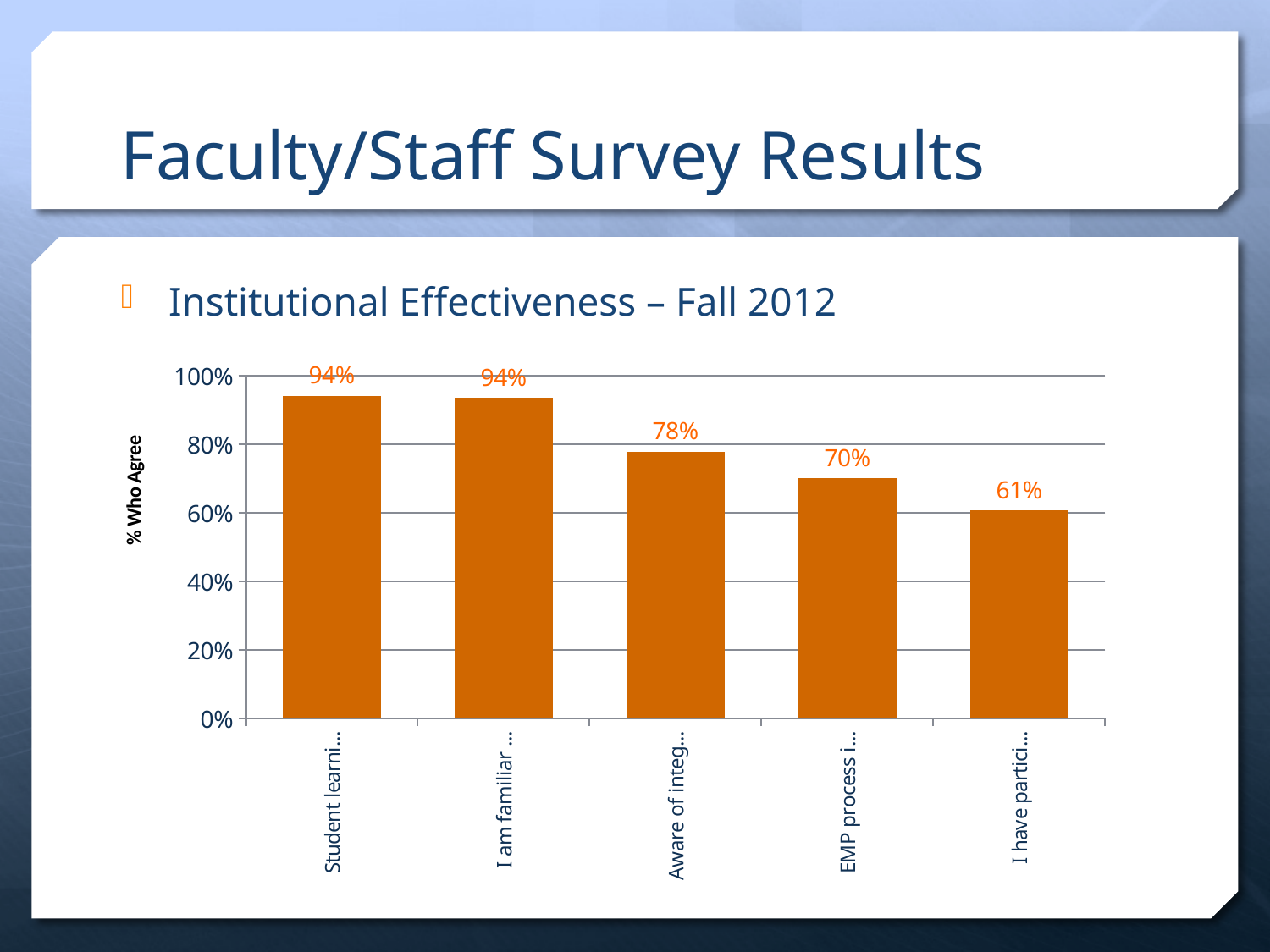
How many bars are shown on the chart? 5 What is the value for the bar labelled "EMP process i..."? 70% Which is larger, the value for "Aware of integ..." or the value for "EMP process i..."? Aware of integ... What is the difference between the first bar ("Student learni...") and the "EMP process i..." bar? 24 percentage points Which bar has the lowest value? I have partici... What is the highest value shown on the chart? 94% What is the value for the first bar on the left, labelled "Student learni..."? 94% What is the value for the last bar on the right, labelled "I have partici..."? 61% Is the value for "EMP process i..." greater or less than 80%? less What is the difference between the "Aware of integ..." bar and the "I have partici..." bar? 17 percentage points What is the value for the bar labelled "Aware of integ..."? 78% What kind of chart is shown on the slide? bar chart